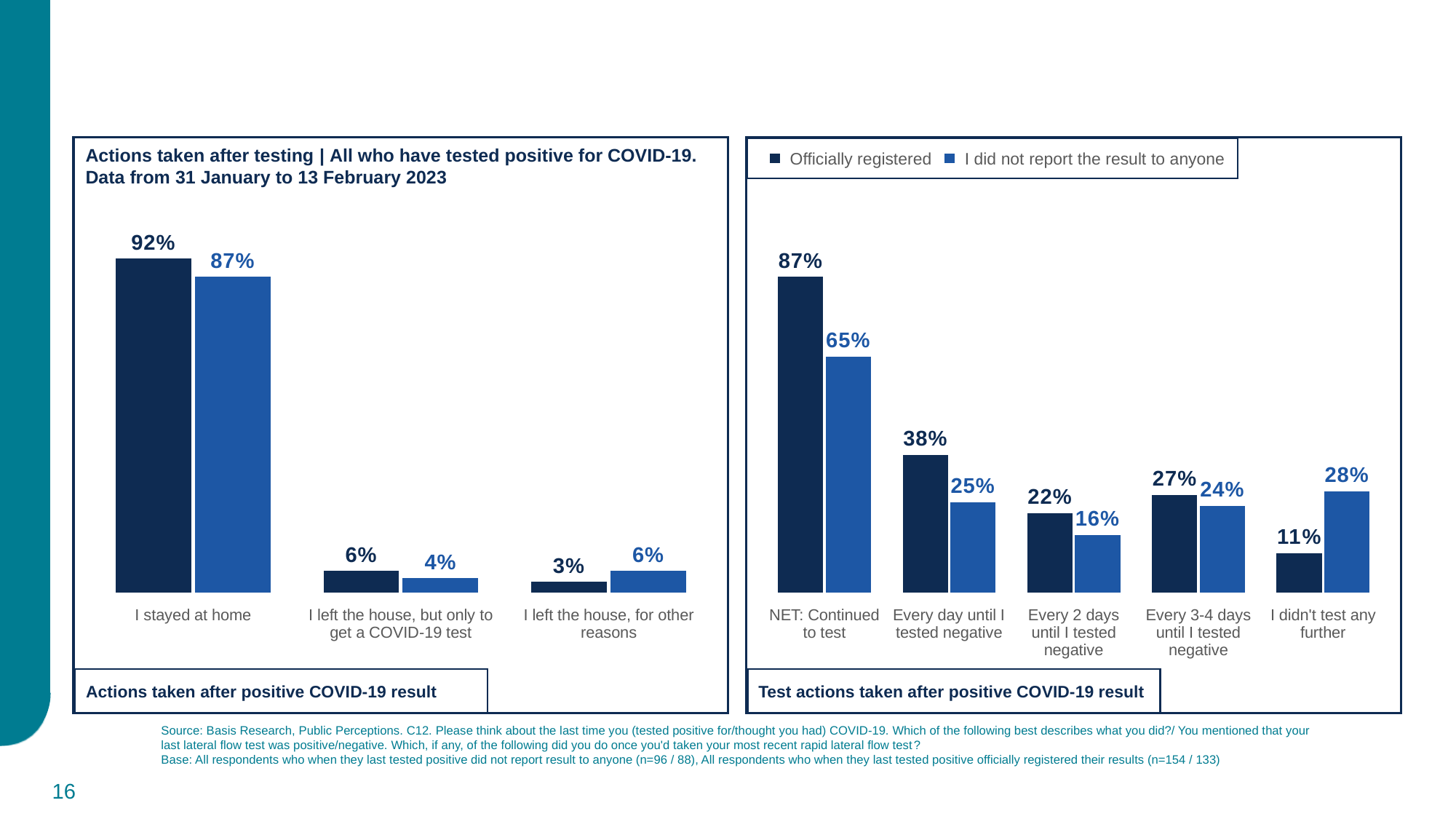
In the 'Test actions taken after positive COVID-19 result' chart, what is the difference between 'Officially registered' and 'I did not report the result to anyone' for 'NET: Continued to test'? 22 percentage points In the 'Test actions taken after positive COVID-19 result' chart, what is the value for 'Every 2 days until I tested negative' among those who did not report the result to anyone? 16% In the 'Test actions taken after positive COVID-19 result' chart, which series has the larger value for 'I didn't test any further'? I did not report the result to anyone In the 'Test actions taken after positive COVID-19 result' chart, how many categories are shown on the x axis? 5 In the 'Actions taken after positive COVID-19 result' chart, how many categories are shown on the x axis? 3 In the 'Actions taken after positive COVID-19 result' chart, what is the value for 'I left the house, for other reasons' among those who did not report the result to anyone? 6% In the 'Test actions taken after positive COVID-19 result' chart, which category has the highest value for the 'I did not report the result to anyone' series? NET: Continued to test In the 'Actions taken after positive COVID-19 result' chart, what is the difference between the two series for 'I stayed at home'? 5 percentage points What type of chart is the 'Actions taken after positive COVID-19 result' chart? Bar chart In the 'Test actions taken after positive COVID-19 result' chart, which category has the lowest value for the 'Officially registered' series? I didn't test any further In the 'Actions taken after positive COVID-19 result' chart, what is the value for 'I stayed at home' among those who officially registered? 92% How many series does the legend list? 2